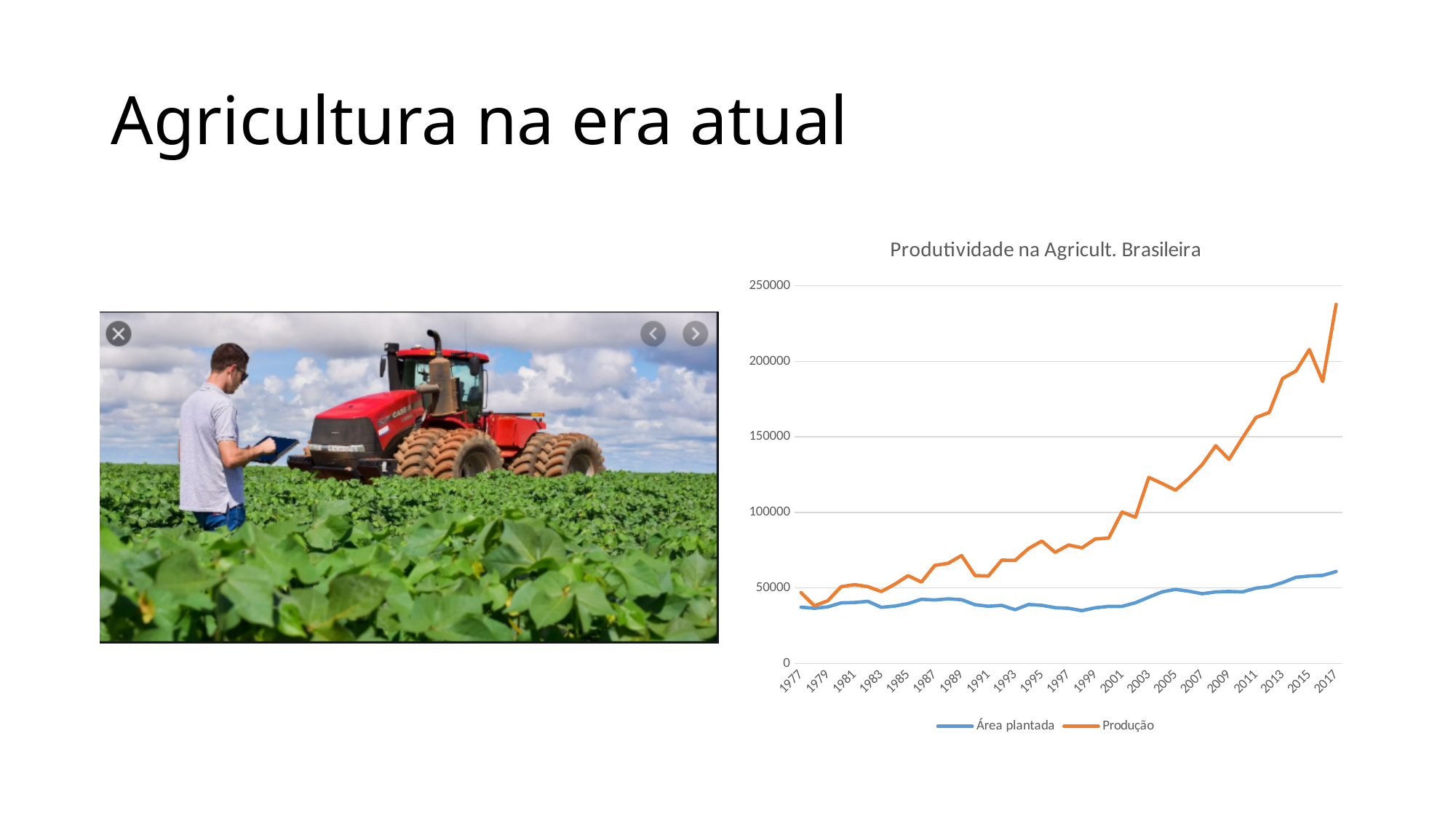
Is the value for Área plantada in 2017 greater or less than 50000? greater Is the value for Área plantada in 1977 greater or less than 50000? less How many series does the chart legend list? 2 Is the value for Produção in 2017 greater or less than 200000? greater What kind of chart is shown on the slide? line chart In which year does the Área plantada series reach its highest value? 2017 In which year does the Produção series reach its highest value? 2017 Which series is drawn in orange in the chart? Produção Does the Produção series generally rise or fall from 1977 to 2017? rise In 2017, which series has the larger value, Área plantada or Produção? Produção What is the title of the chart? Produtividade na Agricult. Brasileira